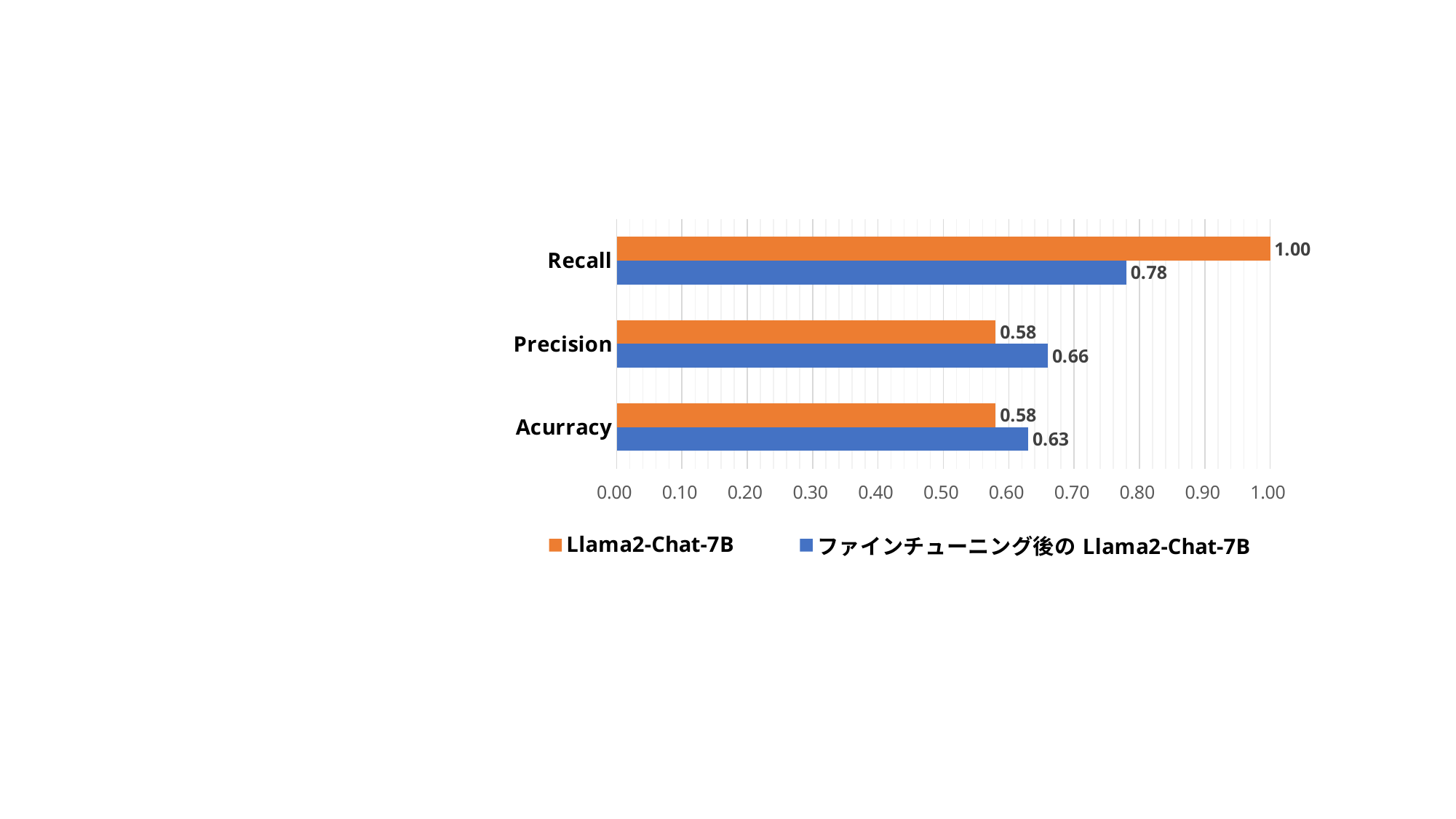
Which series has the larger Precision value, Llama2-Chat-7B or ファインチューニング後の Llama2-Chat-7B? ファインチューニング後の Llama2-Chat-7B How many metric categories are shown on the chart? 3 What is the Precision value for ファインチューニング後の Llama2-Chat-7B? 0.66 Which metric has the lowest value for ファインチューニング後の Llama2-Chat-7B? Acurracy Which metric has the highest value for Llama2-Chat-7B? Recall Is the Acurracy value for ファインチューニング後の Llama2-Chat-7B greater or less than 0.60? greater What is the Acurracy value for Llama2-Chat-7B? 0.58 What is the difference between the Recall values of Llama2-Chat-7B and ファインチューニング後の Llama2-Chat-7B? 0.22 What is the Recall value for ファインチューニング後の Llama2-Chat-7B? 0.78 What kind of chart is shown on the slide? Bar chart What is the Recall value for Llama2-Chat-7B? 1.00 How many series does the legend list? 2